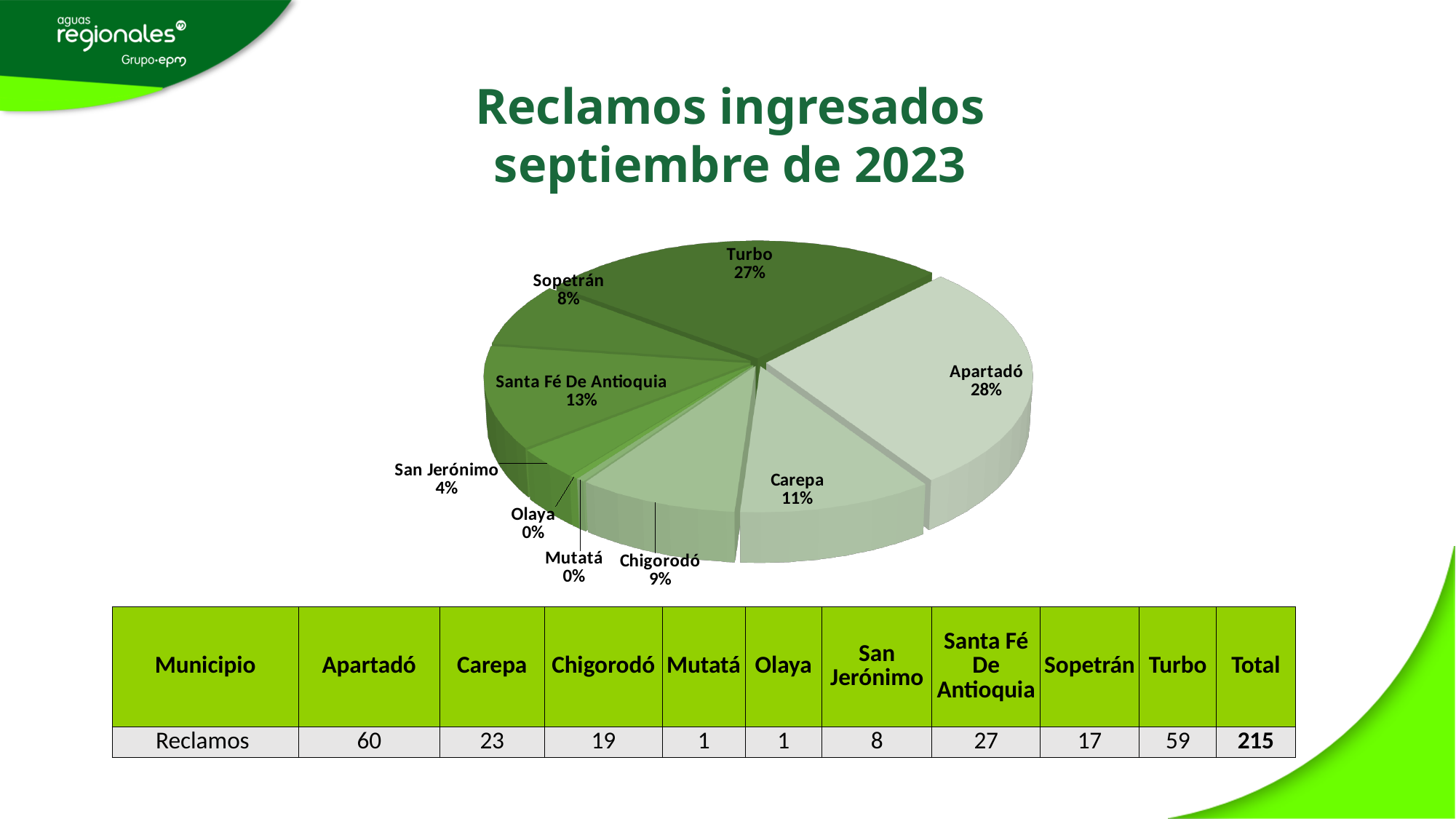
Which municipality has the largest slice of the pie chart? Apartadó What percentage of the pie chart does Chigorodó represent? 9% What is the title of the slide containing the pie chart? Reclamos ingresados septiembre de 2023 What percentage of the pie chart does Apartadó represent? 28% How many slices (municipalities) are labelled in the pie chart? 9 What percentage of the pie chart does Turbo represent? 27% What is the difference in percentage points between the Santa Fé De Antioquia slice and the San Jerónimo slice? 9 What kind of chart is shown on the slide? pie chart Which slice is larger in the pie chart, Carepa or Sopetrán? Carepa What percentage of the pie chart does Santa Fé De Antioquia represent? 13% What is the share of the pie chart labelled for Sopetrán? 8% Which municipalities are labelled with 0% in the pie chart? Olaya and Mutatá